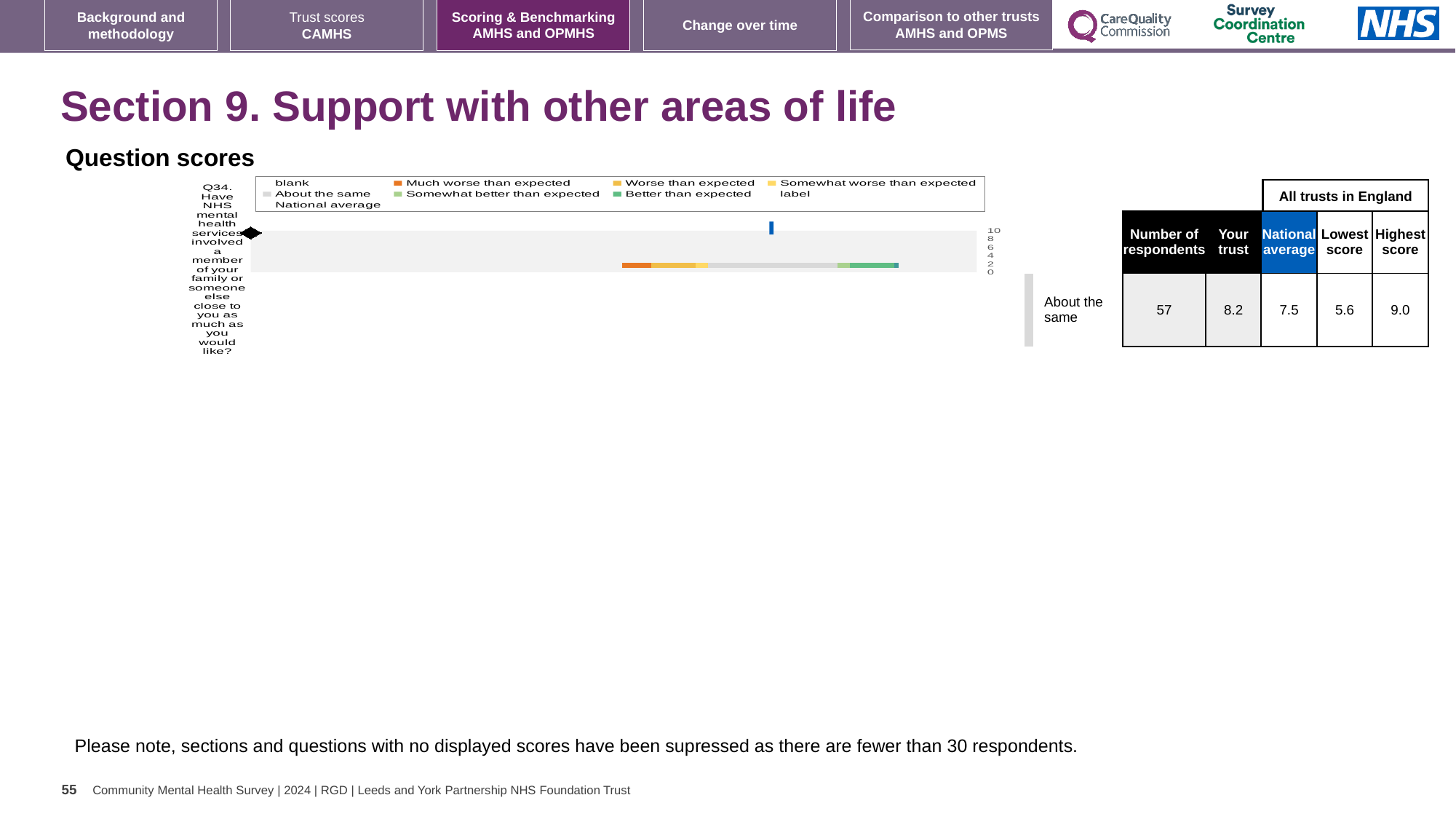
Which legend entry in the Question scores chart is shown in orange? Much worse than expected What is the difference between the trust's score and the national average for Q34? 0.7 What kind of chart is used to show the Q34 question score? bar chart What is the highest value shown on the score axis of the Question scores chart? 10 Which is larger for Q34, the trust's score or the national average? the trust's score How many respondents answered Q34? 57 What is the highest score among all trusts in England for Q34? 9.0 What is the 'Your trust' score for Q34? 8.2 What is the national average score for Q34? 7.5 How many entries does the legend of the Question scores chart list? 9 How many questions are plotted in the Question scores chart? 1 What is the lowest score among all trusts in England for Q34? 5.6